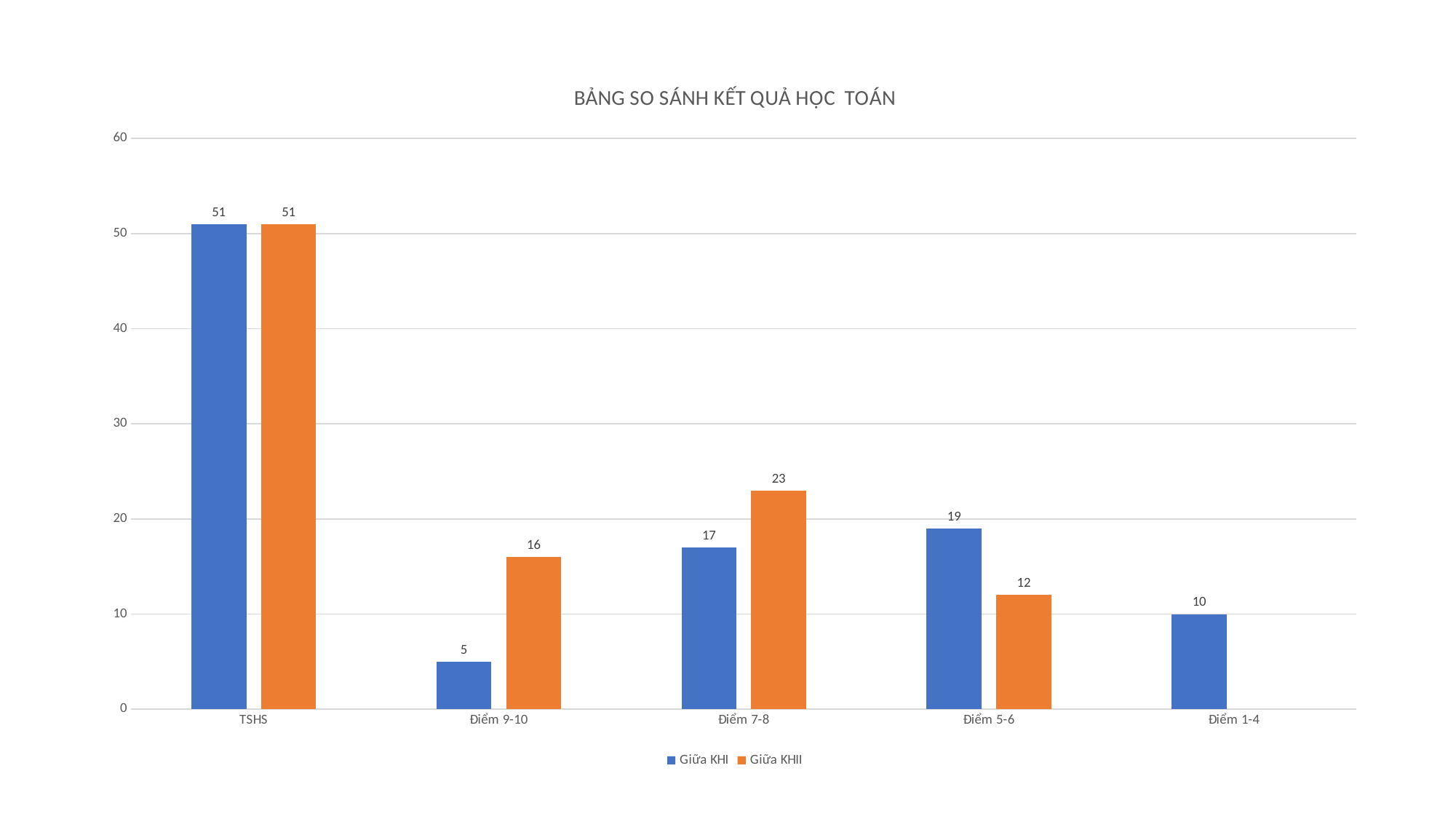
In the Điểm 5-6 category, which series has the larger value, Giữa KHI or Giữa KHII? Giữa KHI Which category has the highest value for the Giữa KHII series? TSHS Excluding TSHS, which category has the lowest value for the Giữa KHI series? Điểm 9-10 How many categories are shown on the x axis? 5 Is the value for Giữa KHII in the Điểm 7-8 category greater or less than 20? greater What is the title of the chart? BẢNG SO SÁNH KẾT QUẢ HỌC TOÁN What is the value for Giữa KHI in the Điểm 1-4 category? 10 What is the value for Giữa KHI in the Điểm 9-10 category? 5 What kind of chart is shown on the slide? Bar chart What is the difference between Giữa KHII and Giữa KHI in the Điểm 9-10 category? 11 How many series does the legend list? 2 What is the value for Giữa KHII in the Điểm 7-8 category? 23